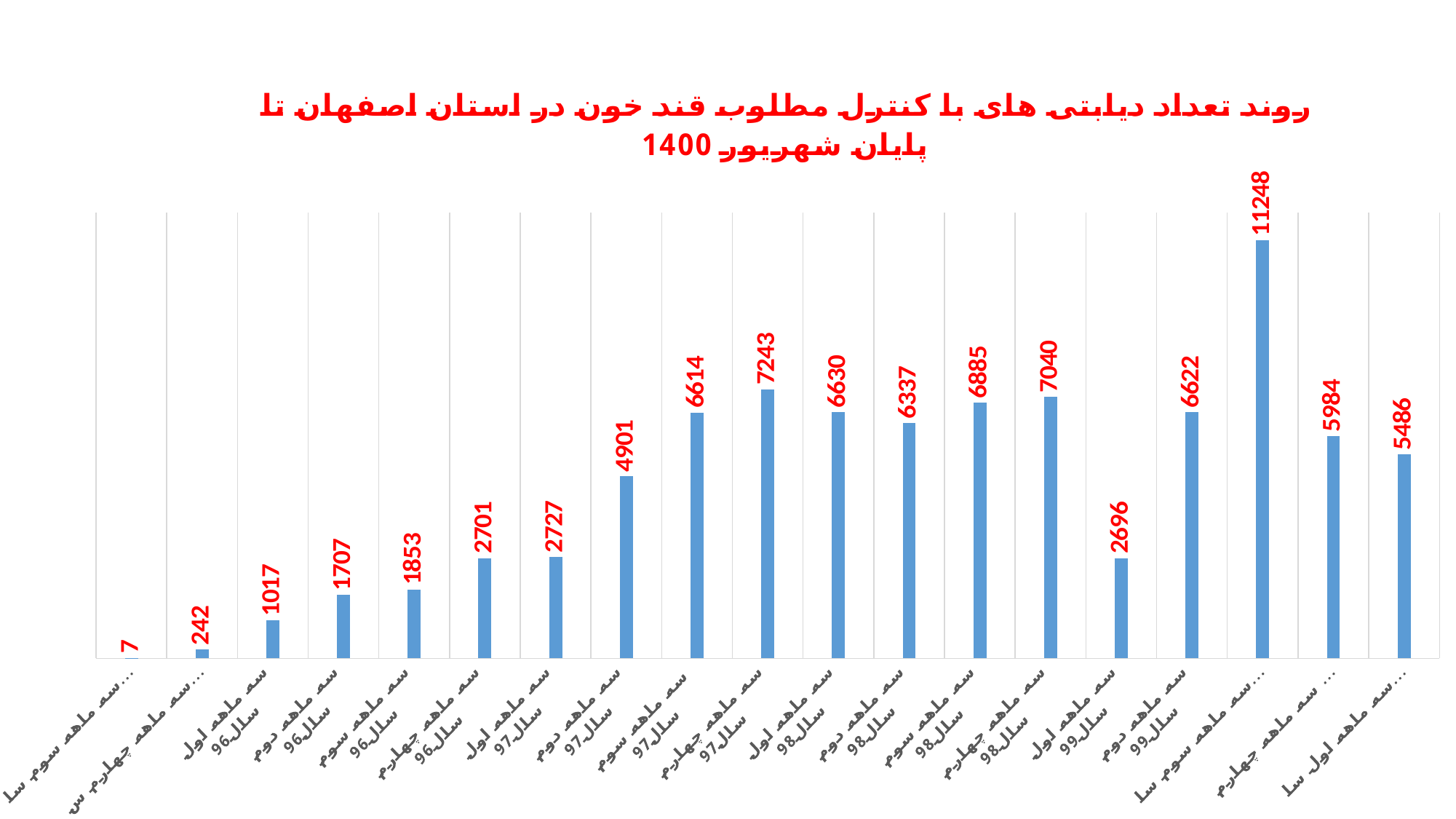
What is the difference between the values for سه ماهه چهارم سال98 and سه ماهه سوم سال98? 155 What colour are the bars in the chart? blue Which is larger, the value for سه ماهه دوم سال97 or the value for سه ماهه سوم سال97? سه ماهه سوم سال97 What is the value for سه ماهه اول سال96? 1017 What is the value for سه ماهه چهارم سال97? 7243 How many bars are plotted in the chart? 19 What is the highest value shown in the chart? 11248 Do the values rise or fall from سه ماهه اول سال96 to سه ماهه چهارم سال97? rise What is the value for سه ماهه دوم سال98? 6337 What is the lowest value shown in the chart? 7 What type of chart is shown on the slide? bar chart What is the value for سه ماهه اول سال99? 2696